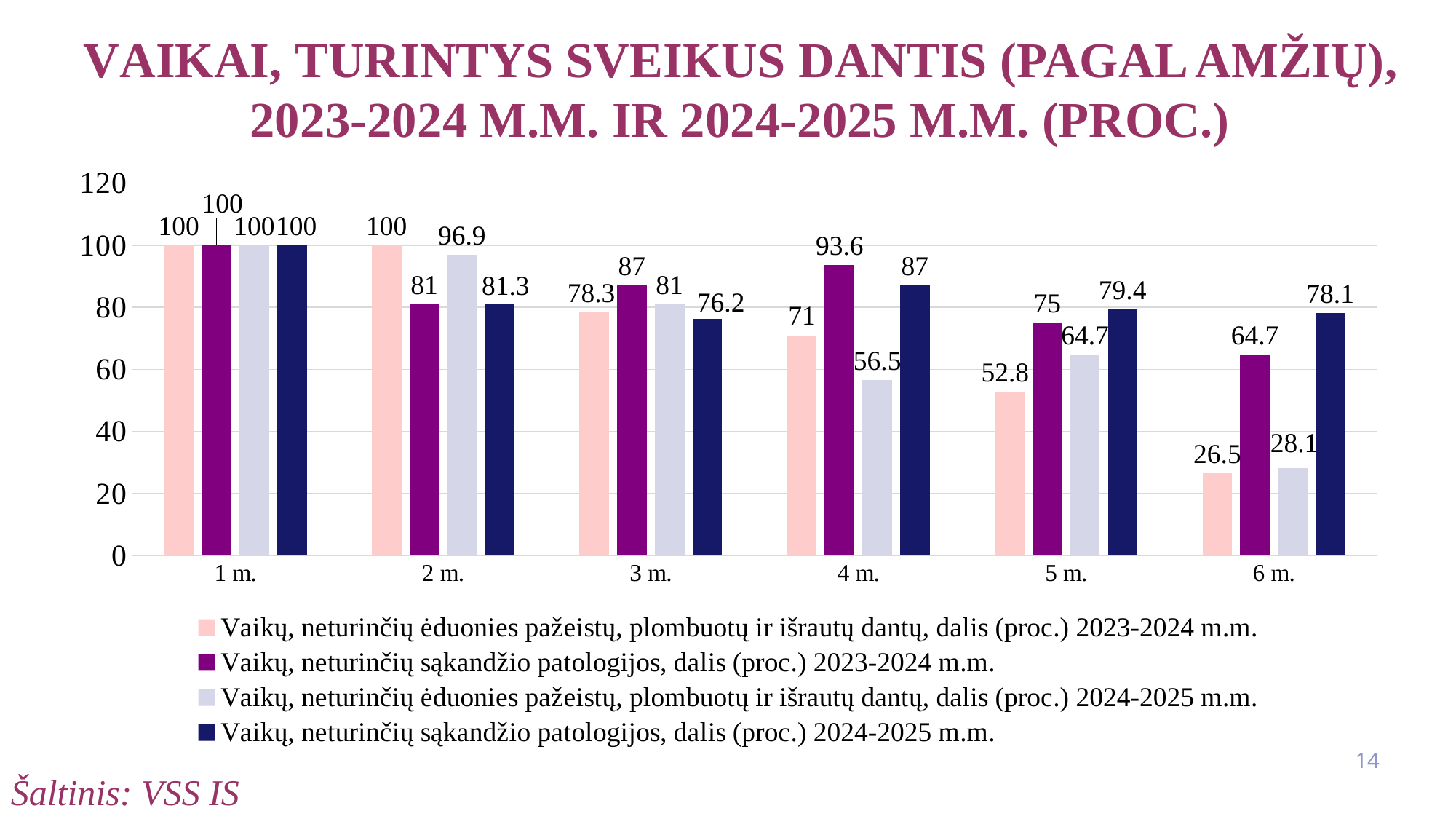
What is the difference between the 2023-2024 m.m. and 2024-2025 m.m. values for 'Vaikų, neturinčių sąkandžio patologijos' at 6 m.? 13.4 What type of chart is shown on the slide? bar chart How many age categories are shown on the x axis? 6 What is the value for 4 m. in the series 'Vaikų, neturinčių sąkandžio patologijos, dalis (proc.) 2023-2024 m.m.'? 93.6 At 5 m., which is larger: the 'Vaikų, neturinčių sąkandžio patologijos' value for 2023-2024 m.m. or for 2024-2025 m.m.? 2024-2025 m.m. What is the value for 6 m. in the series 'Vaikų, neturinčių ėduonies pažeistų, plombuotų ir išrautų dantų, dalis (proc.) 2024-2025 m.m.'? 28.1 Which age category has the lowest value in the series 'Vaikų, neturinčių ėduonies pažeistų, plombuotų ir išrautų dantų, dalis (proc.) 2023-2024 m.m.'? 6 m. How many series does the legend list? 4 Does the series 'Vaikų, neturinčių ėduonies pažeistų, plombuotų ir išrautų dantų, dalis (proc.) 2023-2024 m.m.' rise or fall from 1 m. to 6 m.? fall Which age category has the highest value in the series 'Vaikų, neturinčių sąkandžio patologijos, dalis (proc.) 2024-2025 m.m.'? 1 m. What is the source cited at the bottom of the slide? VSS IS What is the value for 2 m. in the series 'Vaikų, neturinčių ėduonies pažeistų, plombuotų ir išrautų dantų, dalis (proc.) 2024-2025 m.m.'? 96.9